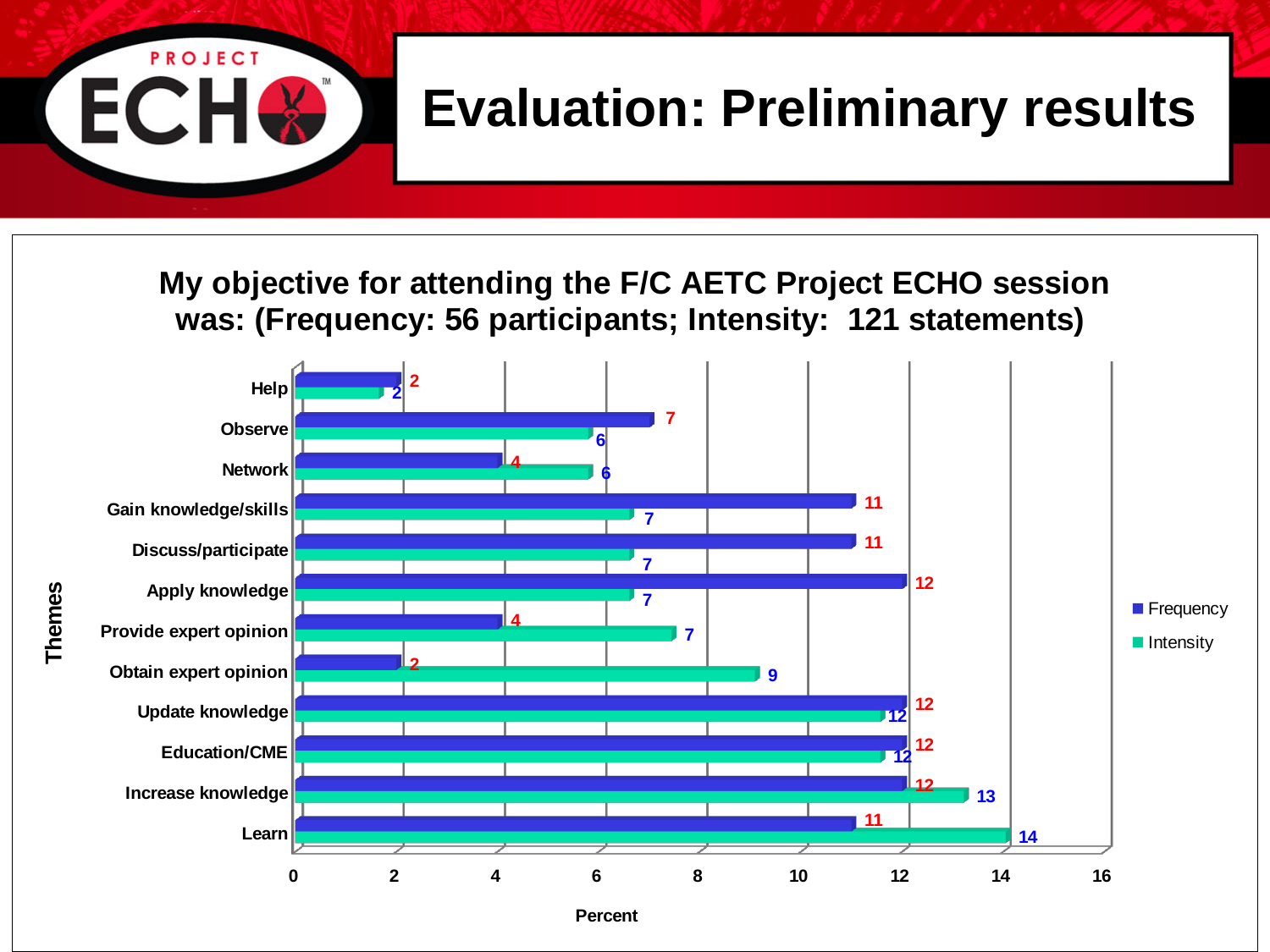
What is the label of the horizontal axis? Percent Which theme has the lowest Intensity value? Help Which theme has the highest Intensity value? Learn How many themes are shown on the chart? 12 How many series does the legend list? 2 What is the difference between the Intensity and Frequency values for Obtain expert opinion? 7 Which is larger for Network: the Frequency value or the Intensity value? Intensity What is the Frequency value for Apply knowledge? 12 Is the Frequency value for Gain knowledge/skills greater or less than 10? greater What is the Intensity value for Learn? 14 What is the Intensity value for Obtain expert opinion? 9 What kind of chart is shown on the slide? Bar chart